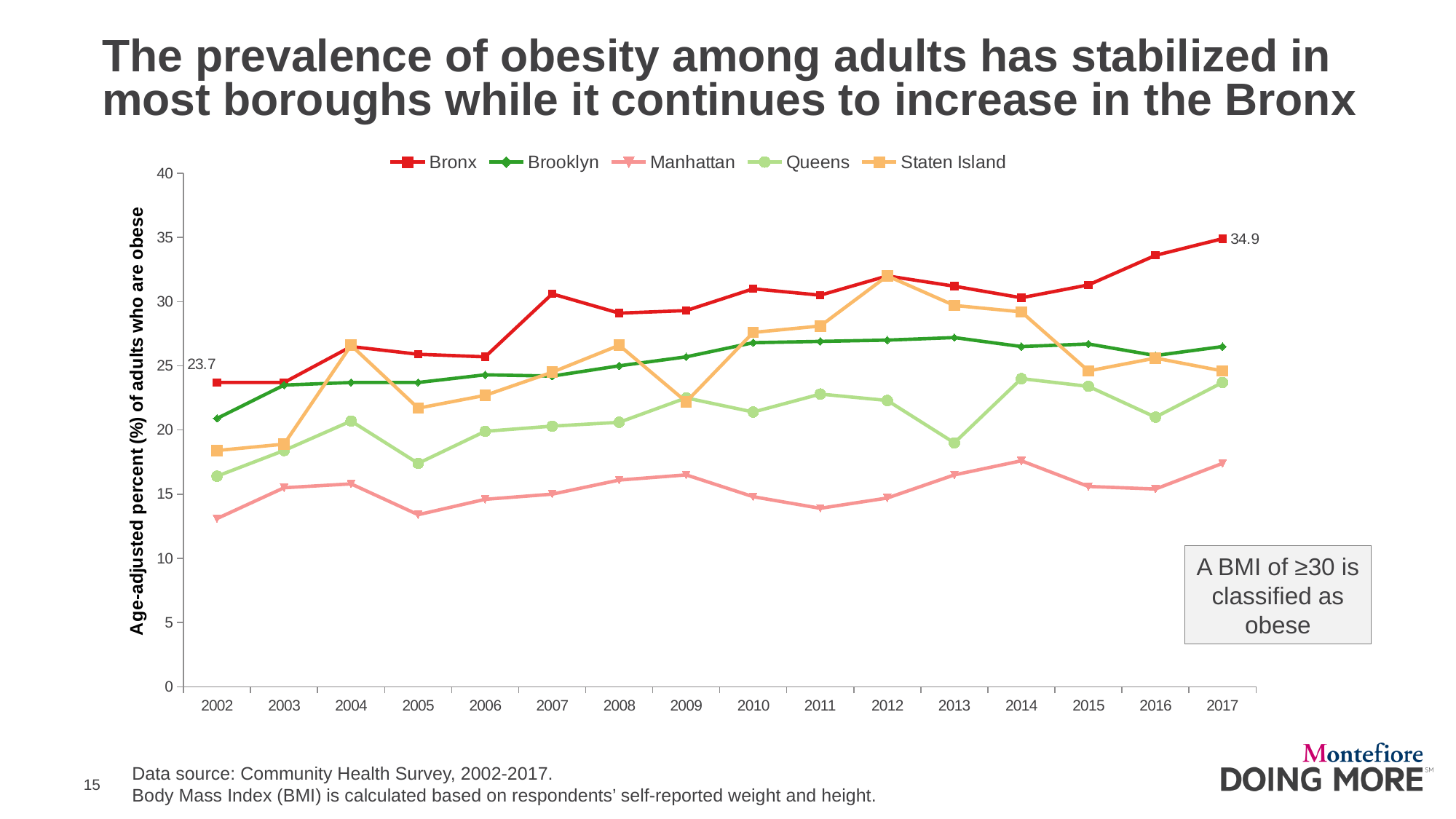
Is the value for Manhattan in 2002 greater or less than 15? less Which is larger in 2002, the value for Brooklyn or the value for Queens? Brooklyn What is the value for the Bronx in 2002? 23.7 How many years are shown on the x axis? 16 How many series does the legend list? 5 What type of chart is shown on the slide? line chart Which borough has the highest obesity prevalence in 2017? Bronx Which borough has the lowest obesity prevalence in 2017? Manhattan What is the value for the Bronx in 2017? 34.9 Is the value for Staten Island in 2012 greater or less than 30? greater By how much did the Bronx value increase from 2002 to 2017? 11.2 What is the label of the y axis? Age-adjusted percent (%) of adults who are obese